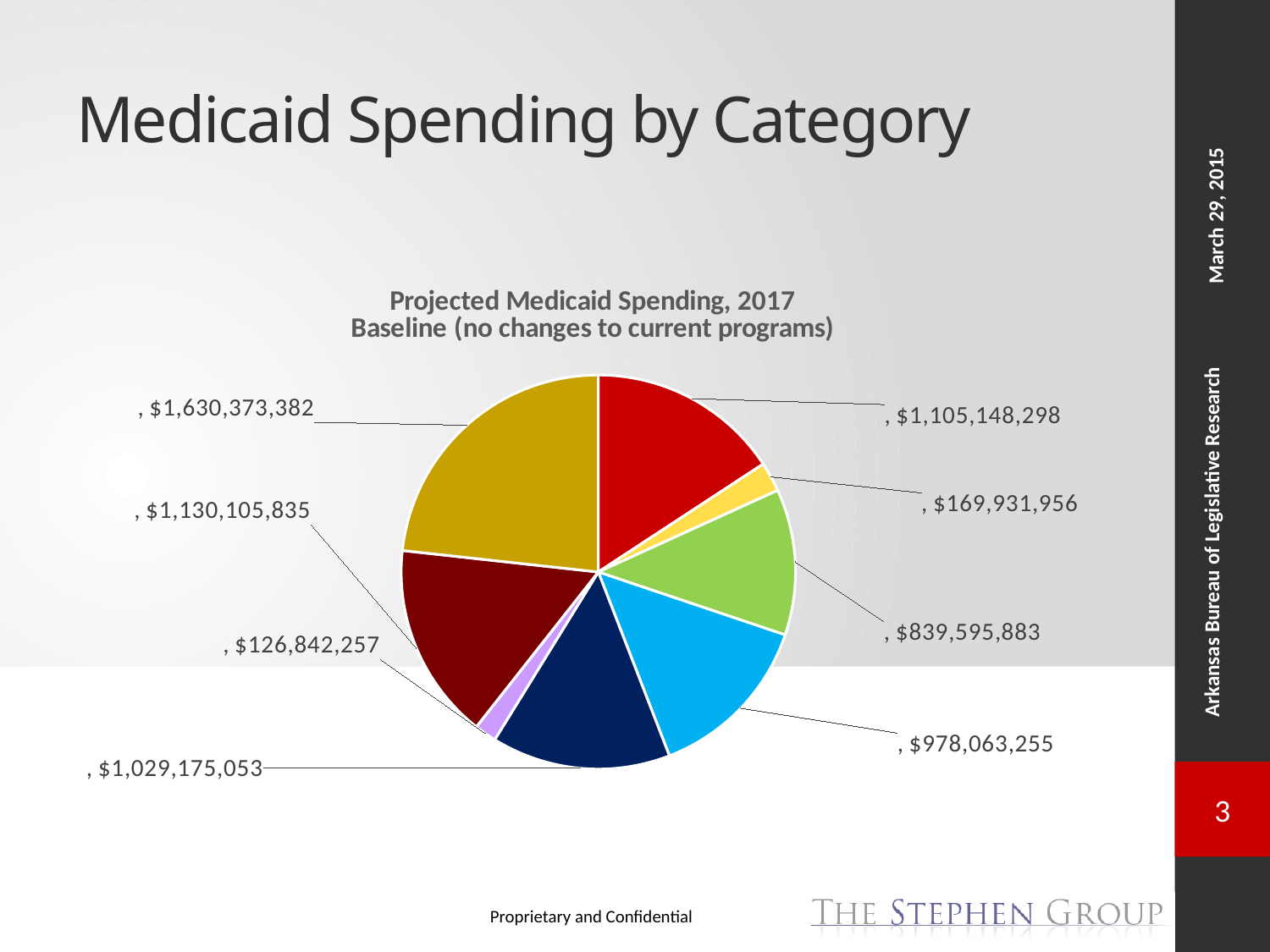
What value is labelled on the light blue slice of the pie chart? $978,063,255 What is the value of the smallest slice of the pie chart? $126,842,257 How many slices does the pie chart have? 8 What kind of chart is shown on the slide? Pie chart What is the value of the largest slice of the pie chart? $1,630,373,382 What is the title of the pie chart? Projected Medicaid Spending, 2017 Baseline (no changes to current programs) What is the total of all the slice values shown on the pie chart? $7,009,235,919 What is the difference between the largest slice ($1,630,373,382) and the smallest slice ($126,842,257)? $1,503,531,125 What value is labelled on the gold (top-left) slice of the pie chart? $1,630,373,382 What value is labelled on the red (top-right) slice of the pie chart? $1,105,148,298 What value is labelled on the green slice of the pie chart? $839,595,883 Which is larger: the dark blue slice ($1,029,175,053) or the light blue slice ($978,063,255)? The dark blue slice ($1,029,175,053)